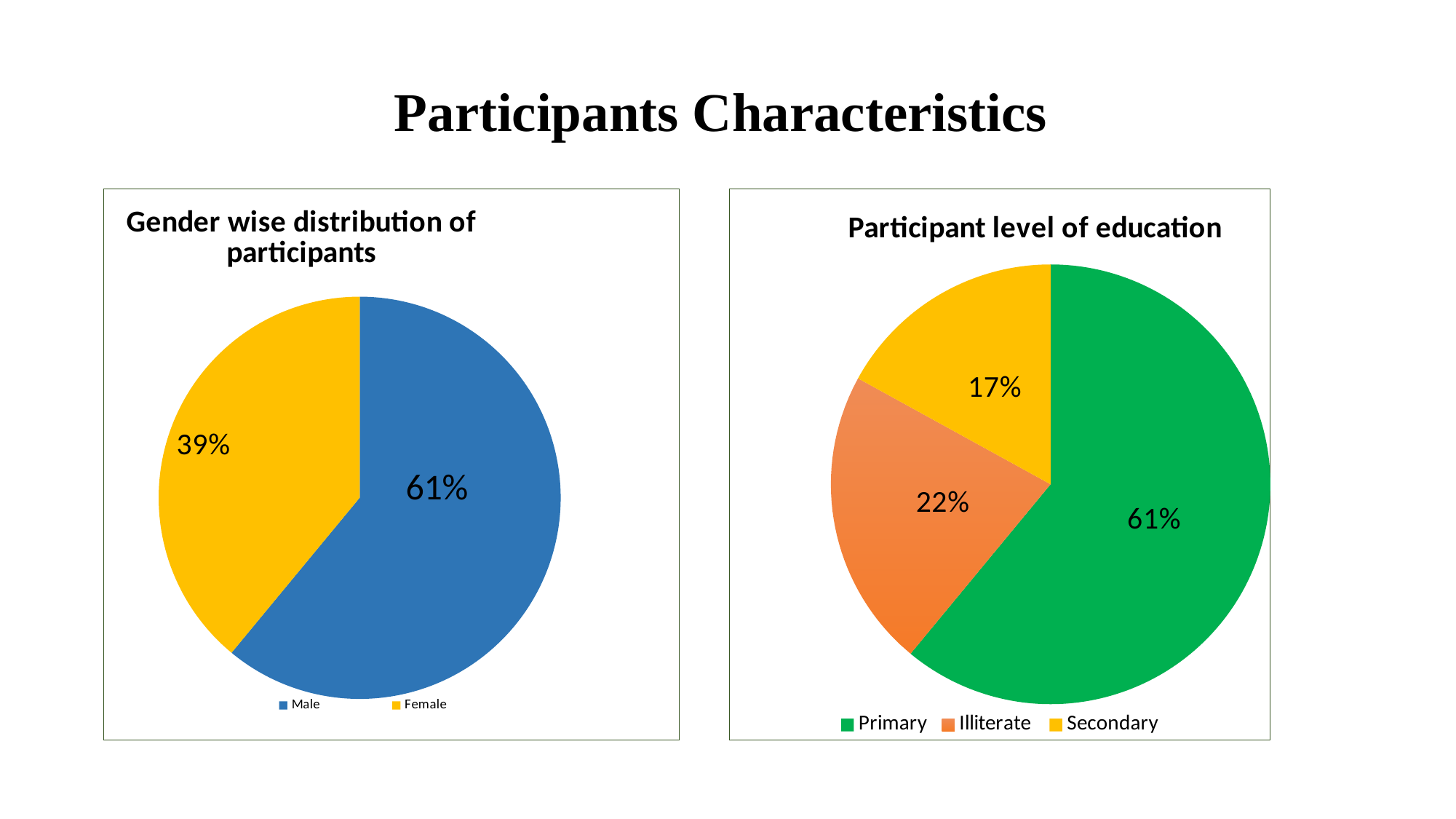
In the 'Participant level of education' chart, what share of participants are Illiterate? 22% How many categories does the legend of the 'Gender wise distribution of participants' chart list? 2 In the 'Gender wise distribution of participants' chart, what share of participants are Female? 39% What kind of chart is the 'Gender wise distribution of participants' chart? Pie chart In the 'Participant level of education' chart, which is larger: the Illiterate share or the Secondary share? Illiterate In the 'Participant level of education' chart, which category has the smallest share? Secondary In the 'Gender wise distribution of participants' chart, what share of participants are Male? 61% How many categories does the legend of the 'Participant level of education' chart list? 3 In the 'Participant level of education' chart, what is the difference between the Primary and Illiterate shares? 39% In the 'Gender wise distribution of participants' chart, which category has the larger share? Male In the 'Gender wise distribution of participants' chart, what is the difference between the Male and Female shares? 22%